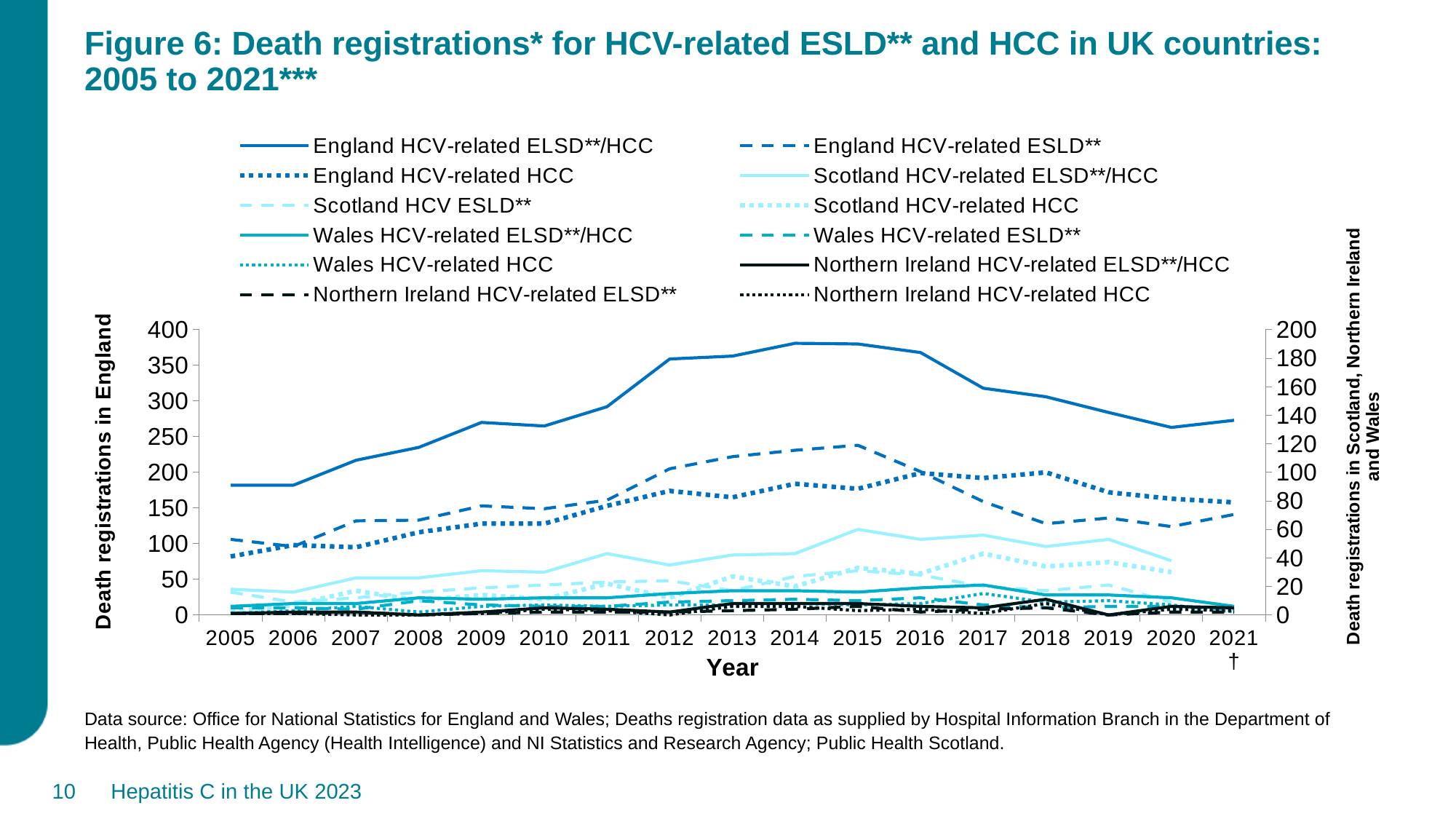
What is the title of the horizontal axis? Year Is the value for England HCV-related ELSD**/HCC in 2014 greater or less than 350? greater Is the value for England HCV-related ELSD** in 2015 greater or less than 200? greater How many years are plotted along the x axis? 17 Is the value for England HCV-related ELSD**/HCC in 2005 greater or less than 200? less What kind of chart is shown on the slide? line chart What is the title of the left vertical axis? Death registrations in England Do the values for England HCV-related ELSD**/HCC rise or fall from 2015 to 2020? fall How many series does the legend list? 12 In 2015, which is larger: England HCV-related ELSD** or England HCV-related HCC? England HCV-related ELSD** Do the values for England HCV-related ELSD**/HCC rise or fall from 2005 to 2014? rise